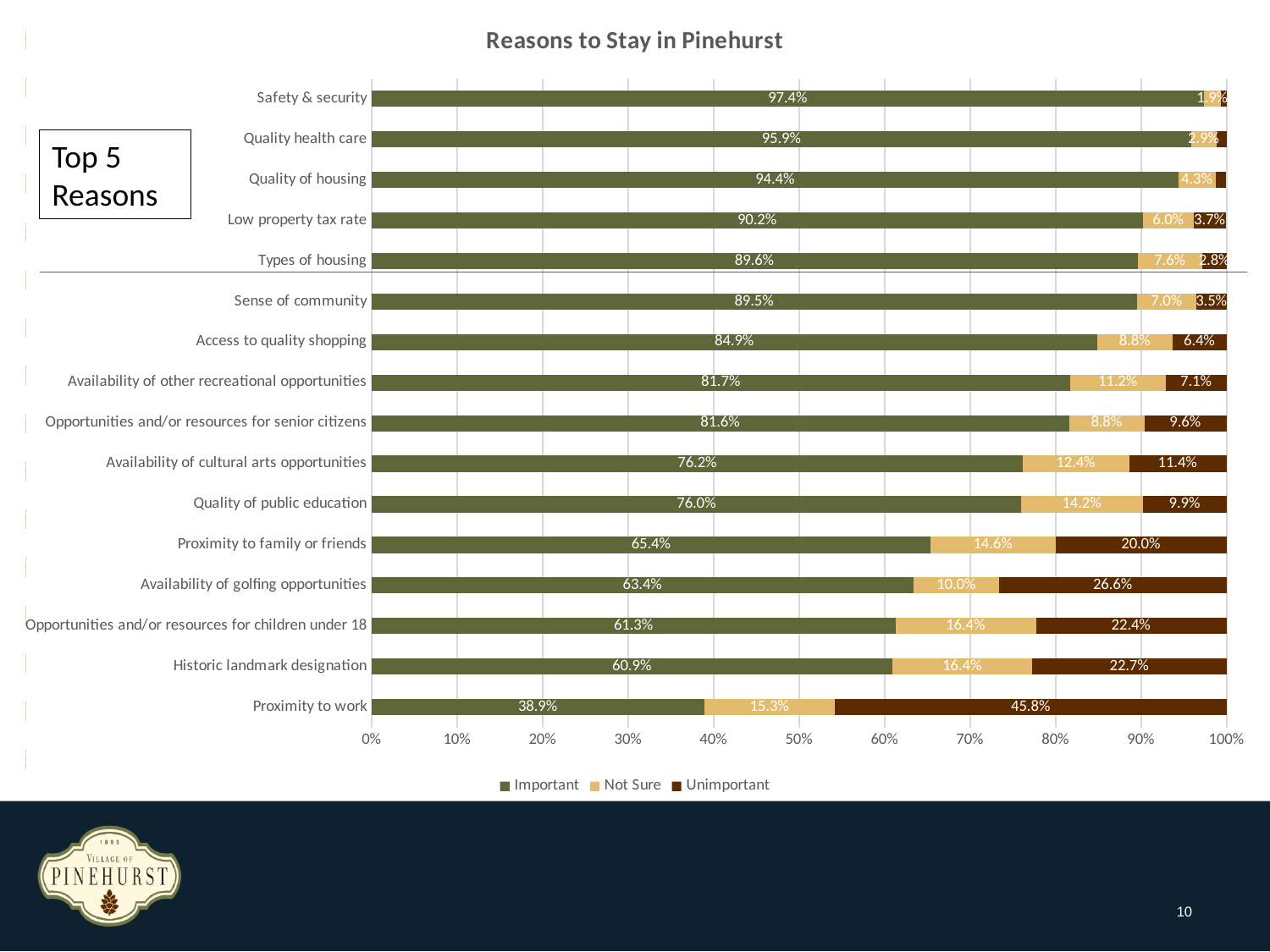
What is the Not Sure value for Quality of public education? 14.2% What kind of chart is shown on the slide? Stacked bar chart Is the Important value for Historic landmark designation greater or less than 70%? less How many reasons are listed on the chart? 16 What is the title of the chart? Reasons to Stay in Pinehurst What percentage of respondents rated Safety & security as Important? 97.4% Which reason has the lowest Important percentage? Proximity to work Which has a larger Unimportant percentage: Availability of golfing opportunities or Proximity to family or friends? Availability of golfing opportunities How many series does the legend list? 3 Which reason has the highest Unimportant percentage? Proximity to work What is the Unimportant value for Proximity to work? 45.8% What is the difference between the Important percentages for Low property tax rate and Types of housing? 0.6%